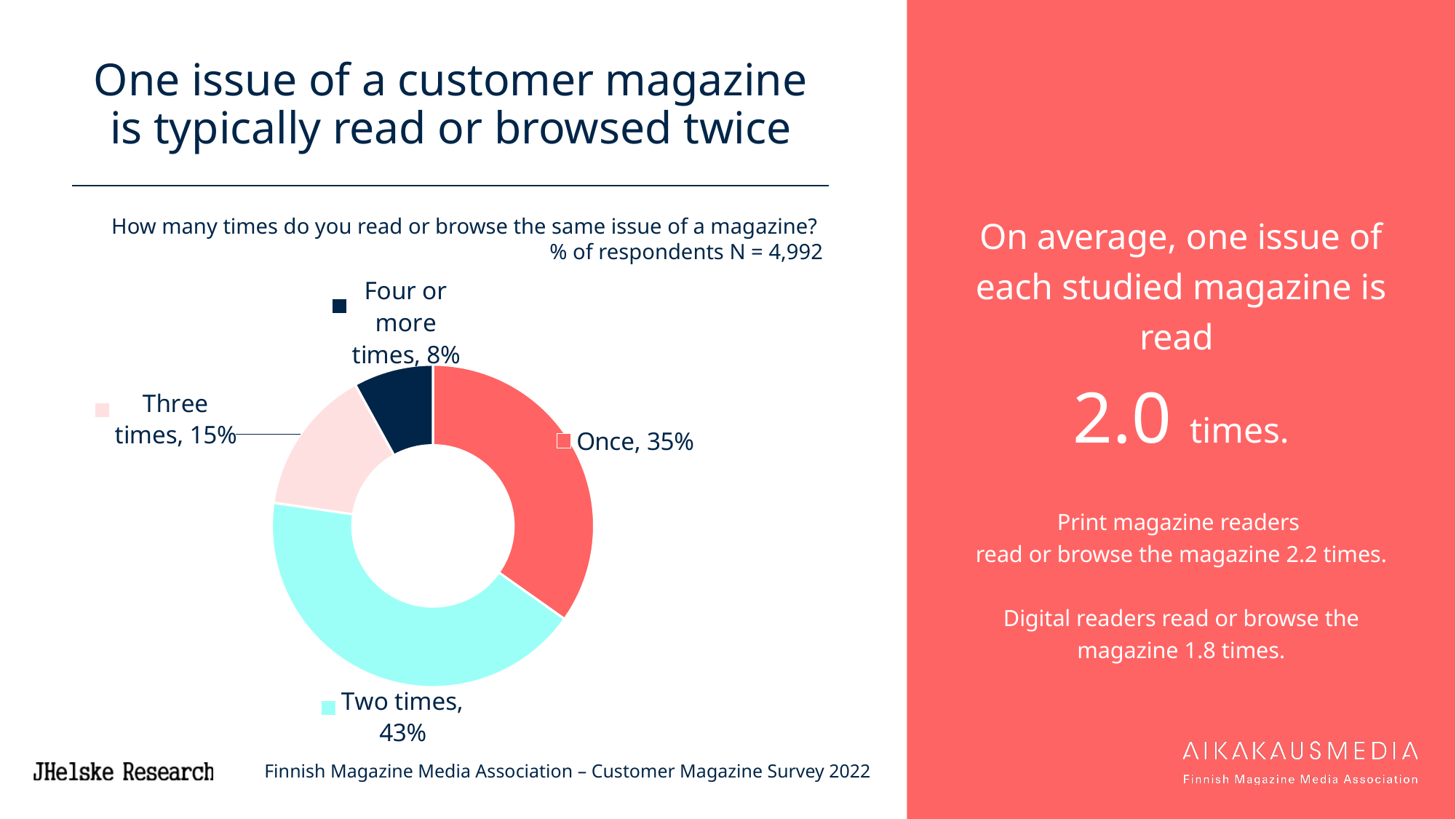
What percentage of respondents read or browse the same issue four or more times? 8% Which category has the largest share of respondents? Two times What kind of chart is shown on the slide? Doughnut (pie) chart What percentage of respondents read or browse the same issue two times? 43% How many categories are shown in the chart? 4 What is the difference in percentage points between 'Three times' and 'Four or more times'? 7 What percentage of respondents read or browse the same issue of a magazine once? 35% How many respondents (N) does the chart state? 4,992 Which category has the smallest share of respondents? Four or more times Which is larger, the share for 'Once' or the share for 'Three times'? Once What is the difference in percentage points between 'Two times' and 'Once'? 8 What percentage of respondents read or browse the same issue three times? 15%